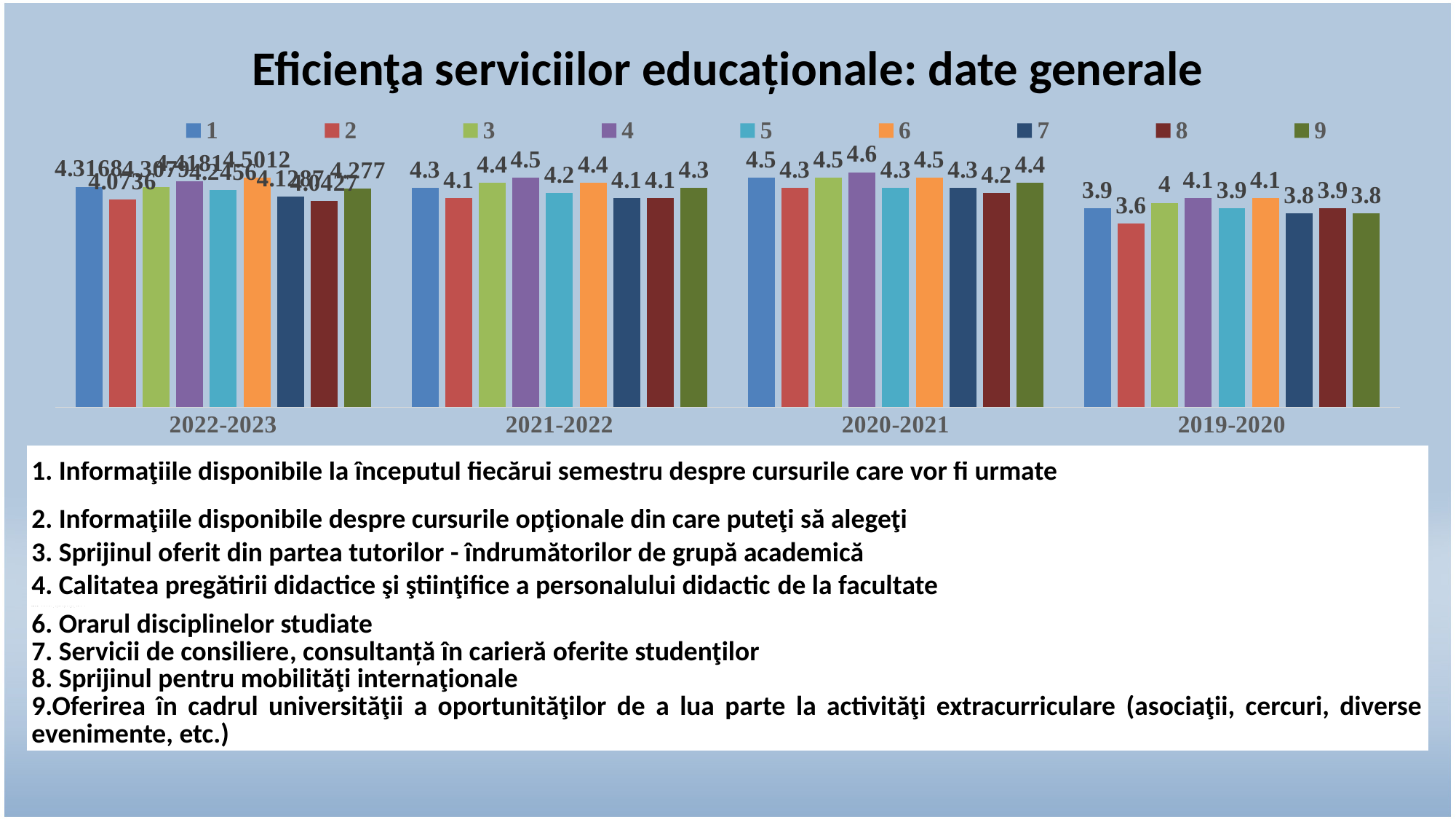
Is the value for series 1 larger in 2021-2022 or in 2019-2020? 2021-2022 What kind of chart is shown on the slide? bar chart How many academic-year categories are shown on the x axis? 4 What is the value for series 4 in 2020-2021? 4.6 What is the difference between series 4 and series 2 in 2019-2020? 0.5 What is the value for series 6 in 2020-2021? 4.5 What is the value for series 2 in 2019-2020? 3.6 What is the title of the chart? Eficienţa serviciilor educaționale: date generale How many series does the legend list? 9 What is the value for series 9 in 2021-2022? 4.3 Which series has the highest value in 2020-2021? 4 Which series has the lowest value in 2019-2020? 2